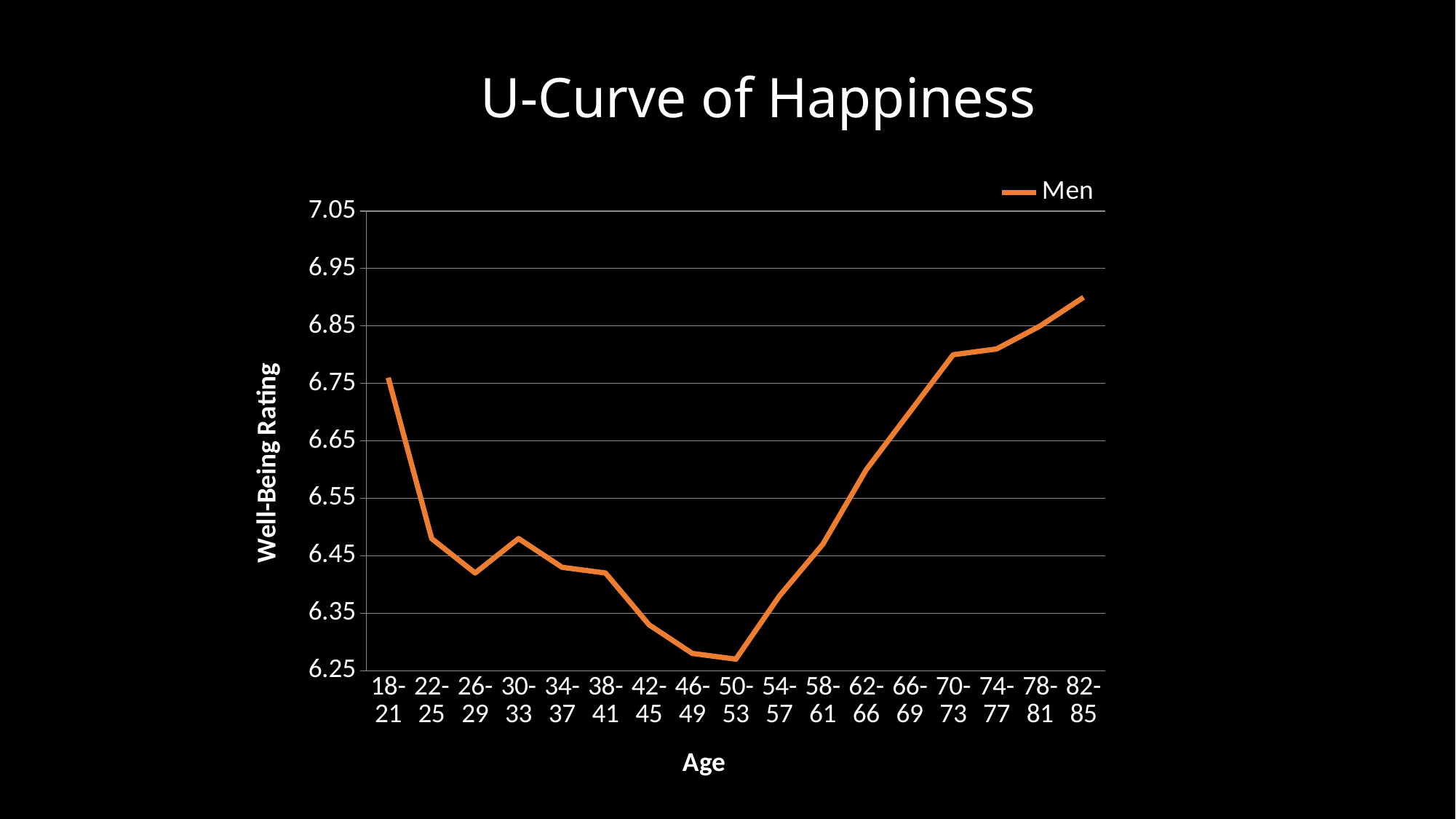
How many age groups are plotted along the x axis? 17 Is the value for the 50-53 age group greater or less than 6.35? less Is the value for the 46-49 age group greater or less than 6.35? less What kind of chart is shown on the slide? Line chart What is the label on the y axis? Well-Being Rating Do the values rise or fall from the 50-53 age group to the 82-85 age group? Rise What is the title of the chart? U-Curve of Happiness Is the value for the 70-73 age group greater or less than 6.75? greater Which has the higher well-being rating, the 18-21 age group or the 62-66 age group? 18-21 How many series does the legend list? 1 Which age group has the highest well-being rating? 82-85